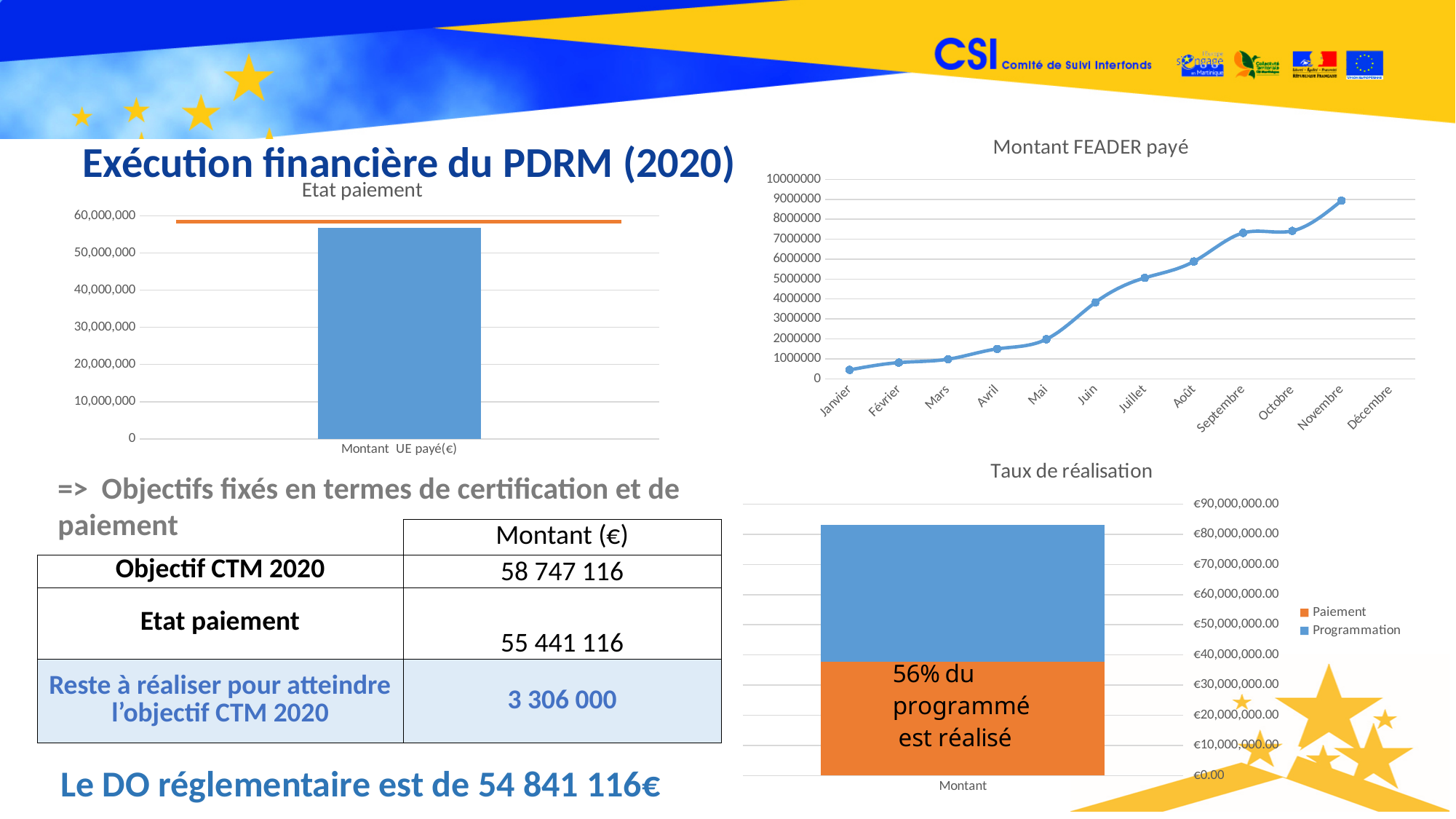
What are the legend entries of the 'Taux de réalisation' chart? Paiement, Programmation In the 'Montant FEADER payé' chart, which month has the highest plotted value? Novembre What kind of chart is the 'Etat paiement' chart? bar chart In the 'Montant FEADER payé' chart, is the value for Juin greater or less than 3000000? greater In the 'Montant FEADER payé' chart, is the value for Novembre greater or less than 8000000? greater How many series does the legend of the 'Taux de réalisation' chart list? 2 In the 'Montant FEADER payé' chart, is the value for Janvier greater or less than 1000000? less How many months are labelled on the x axis of the 'Montant FEADER payé' chart? 12 In the 'Montant FEADER payé' chart, do the values rise or fall from Janvier to Novembre? rise What kind of chart is the 'Montant FEADER payé' chart? line chart In the 'Montant FEADER payé' chart, which month has the lowest plotted value? Janvier